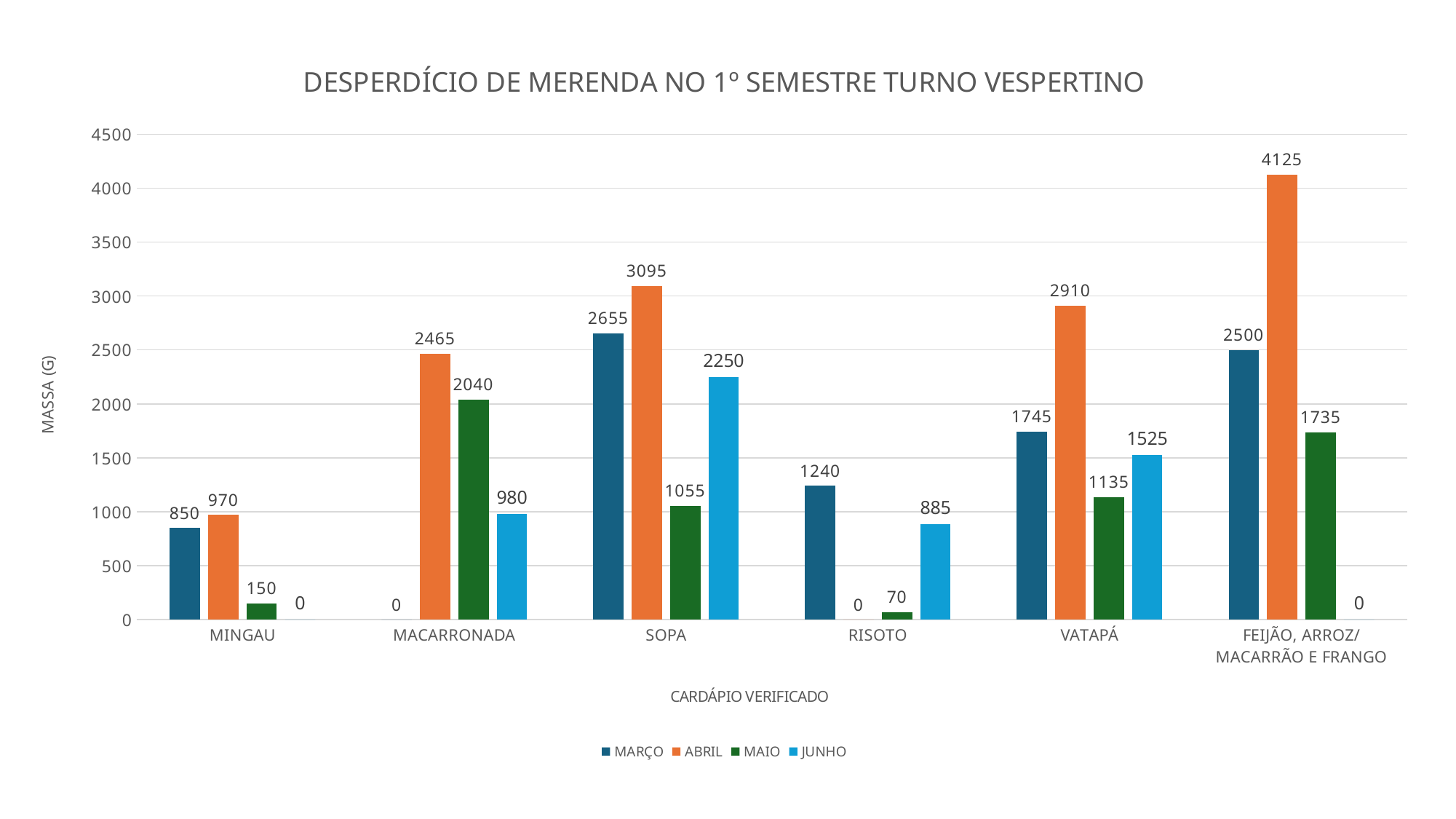
Which is larger for SOPA: the MARÇO value or the JUNHO value? MARÇO What is the difference between the ABRIL and MARÇO values for VATAPÁ? 1165 Which category has the highest ABRIL value? FEIJÃO, ARROZ/ MACARRÃO E FRANGO What is the value for JUNHO for RISOTO? 885 What is the value for ABRIL for SOPA? 3095 What kind of chart is shown on the slide? bar chart How many categories are shown on the x axis? 6 Which category has the lowest MARÇO value? MACARRONADA How many series does the legend list? 4 What is the value for MAIO for MACARRONADA? 2040 Is the MAIO value for FEIJÃO, ARROZ/ MACARRÃO E FRANGO greater or less than 1500? greater What is the label of the y axis? MASSA (G)